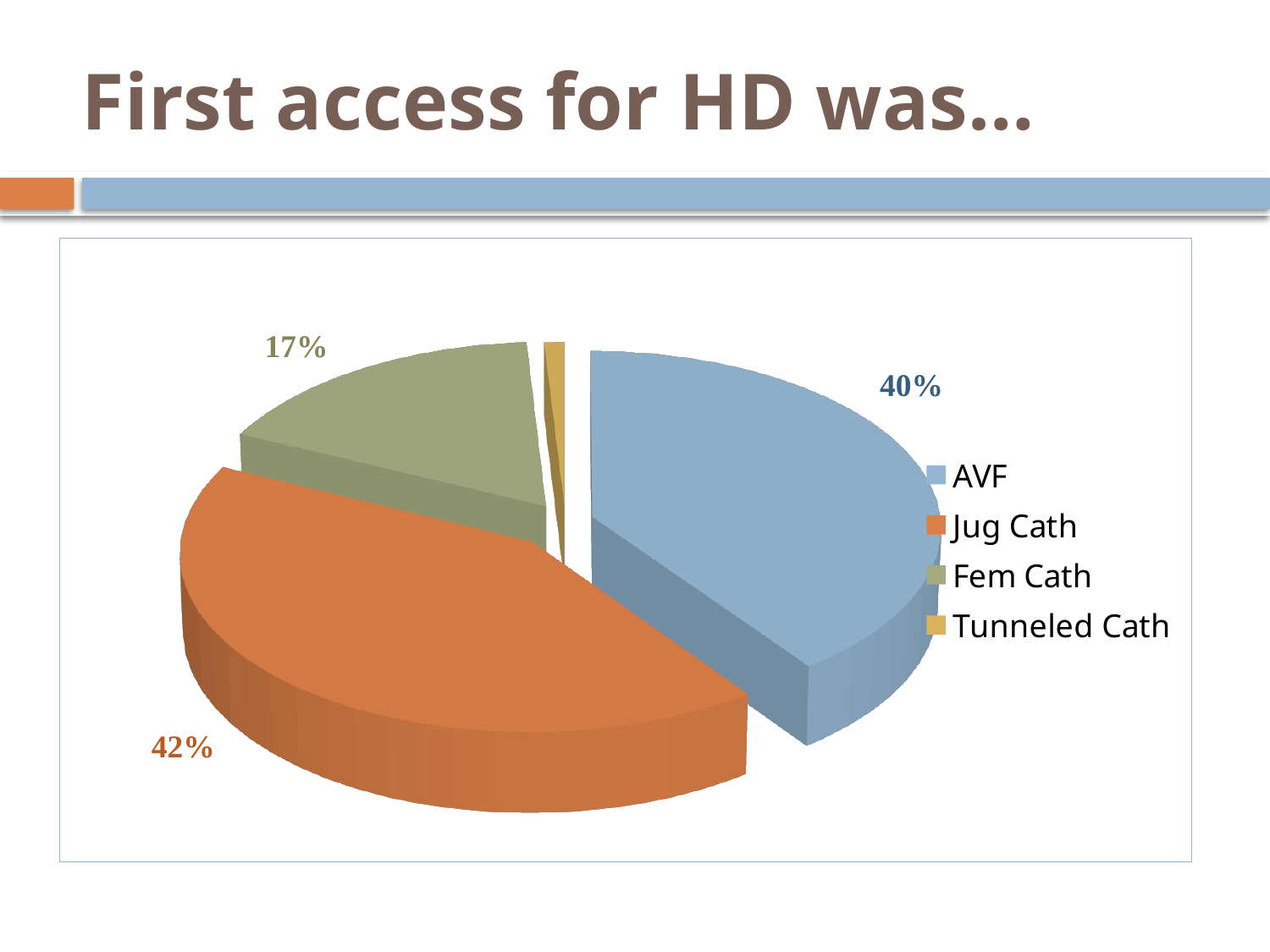
Which category has the smallest share of the pie? Tunneled Cath Which is larger, the share for AVF or the share for Fem Cath? AVF What percentage of the pie does Fem Cath represent? 17% How many categories are shown in the pie chart? 4 How many entries does the legend list? 4 What kind of chart is shown on the slide? Pie chart What percentage of the pie does Jug Cath represent? 42% What is the difference in percentage points between AVF and Fem Cath? 23% Which category has the largest share of the pie? Jug Cath What is the title of the slide? First access for HD was… What percentage of the pie does AVF represent? 40% What is the difference in percentage points between Jug Cath and AVF? 2%